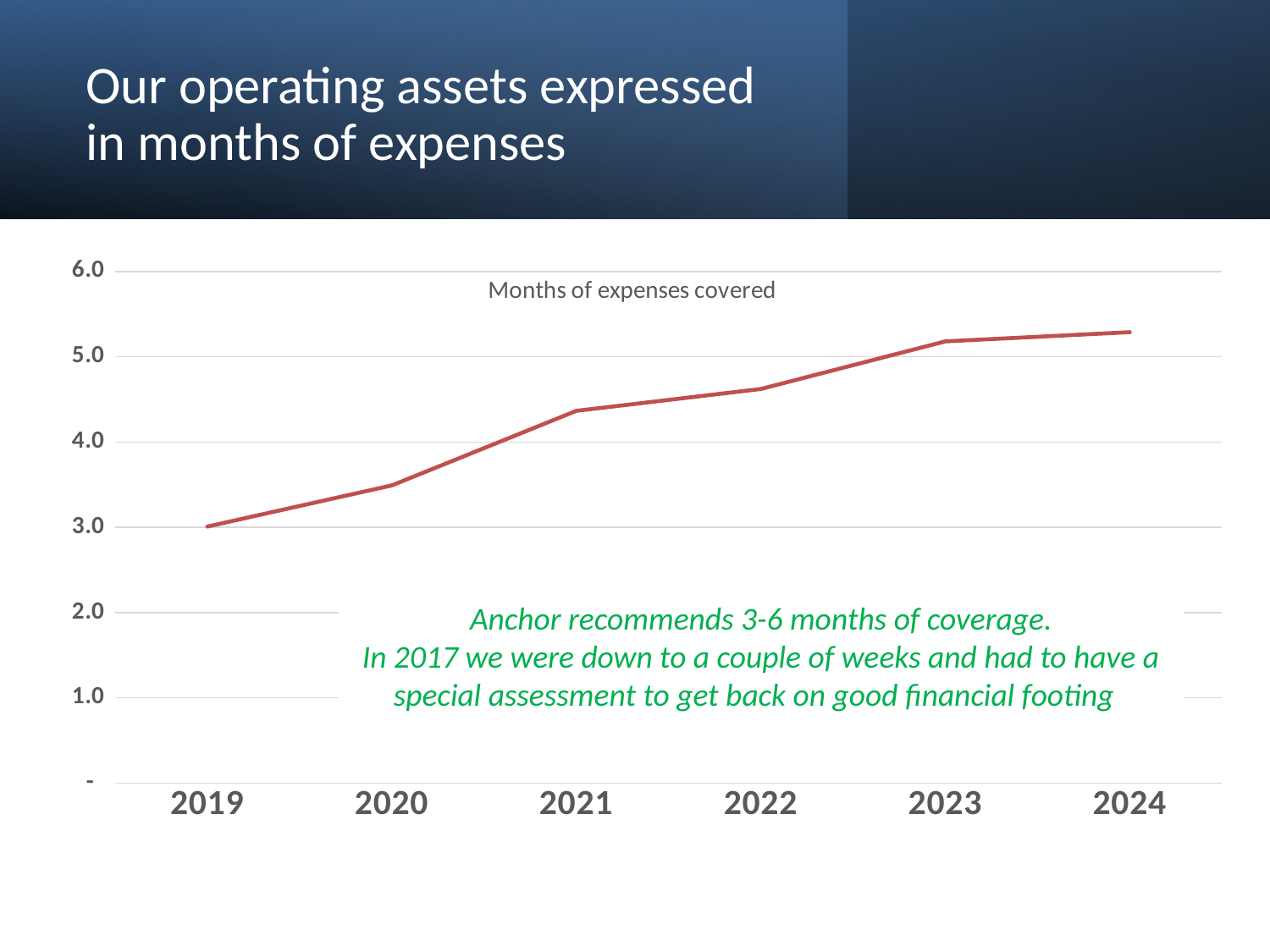
Which year has the lowest value in the chart? 2019 Is the value for 2019 greater or less than 4.0? less Is the value for 2022 greater or less than 5.0? less Which year has the larger value, 2022 or 2023? 2023 Is the value for 2023 greater or less than 5.0? greater Do the values in the chart rise or fall from 2019 to 2024? rise How many years are plotted along the x axis of the chart? 6 What kind of chart is shown on the slide? line chart Which year has the larger value, 2020 or 2021? 2021 What is the title shown inside the chart area? Months of expenses covered